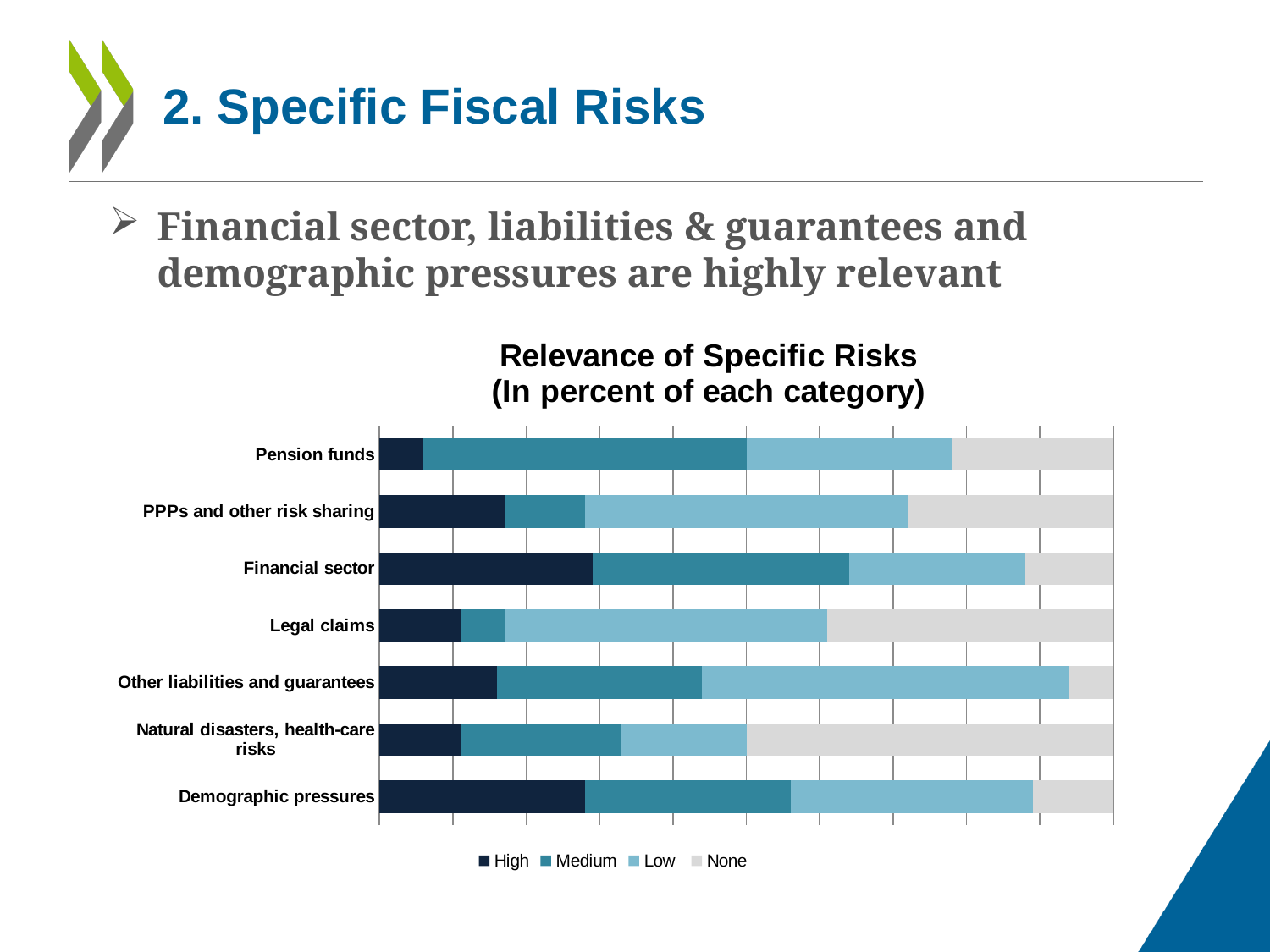
How many risk categories are listed on the chart? 7 What is the title of the chart? Relevance of Specific Risks (In percent of each category) Is the "High" segment larger for Financial sector or for Legal claims? Financial sector Which category has the smallest "Medium" segment? Legal claims How many series does the legend list? 4 What kind of chart is shown on the slide? Stacked bar chart Which category has the largest "Medium" segment? Pension funds Which category has the largest "None" segment? Natural disasters, health-care risks Which category has the smallest "High" segment? Pension funds Which category has the smallest "None" segment? Other liabilities and guarantees What are the four series named in the legend? High, Medium, Low, None Is the "Low" segment larger for PPPs and other risk sharing or for Natural disasters, health-care risks? PPPs and other risk sharing